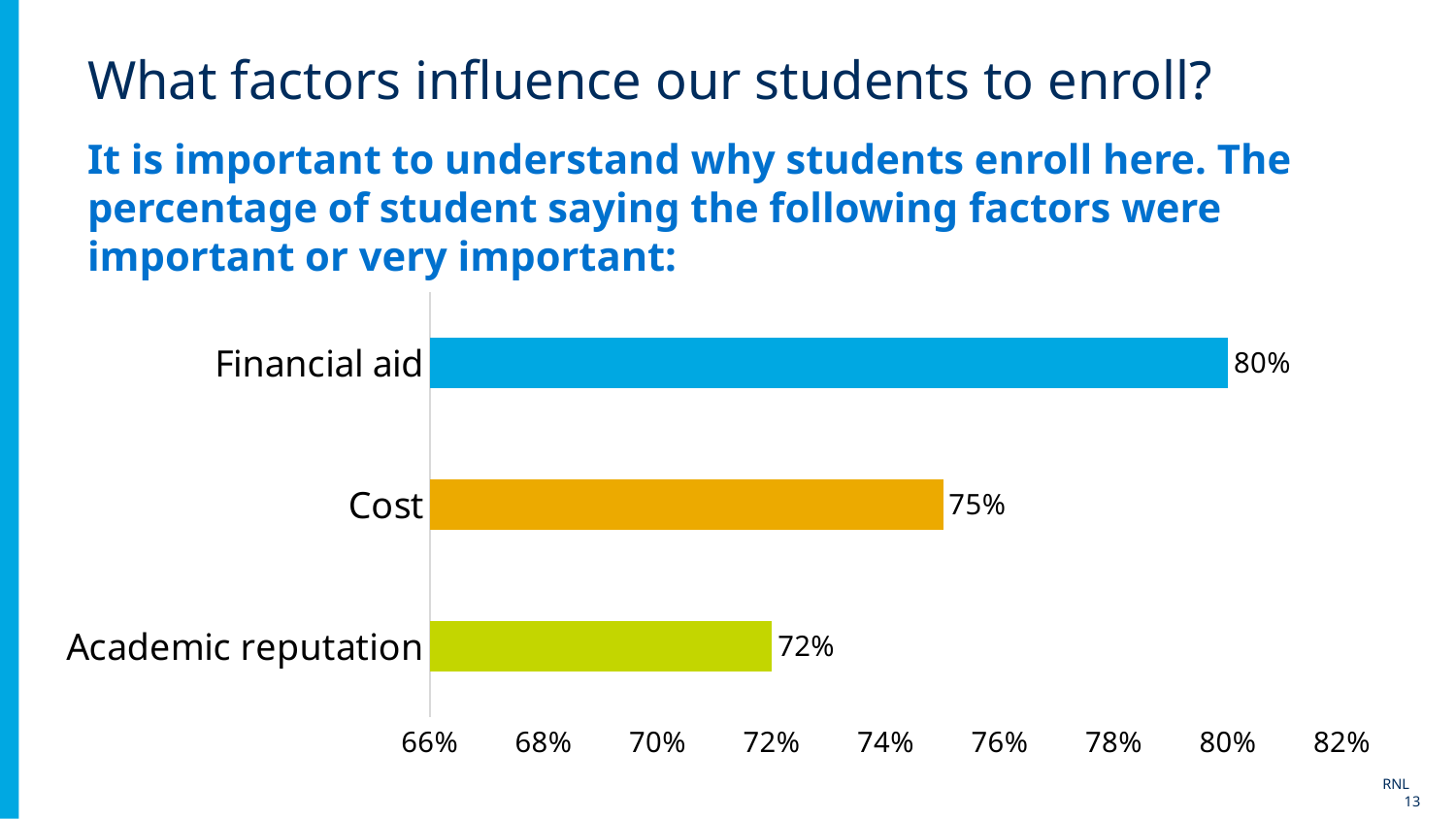
Which is larger, the value for Cost or the value for Academic reputation? Cost Which factor has the lowest percentage? Academic reputation What is the difference between the values for Financial aid and Cost? 5% Is the value for Cost greater or less than 74%? greater What kind of chart is shown on the slide? Bar chart What is the value shown for Cost? 75% How many factors are shown in the chart? 3 What is the value shown for Academic reputation? 72% What is the difference between the values for Cost and Academic reputation? 3% What percentage of students said Financial aid was important or very important? 80% Which factor has the highest percentage? Financial aid What colour is the bar for Financial aid? Blue